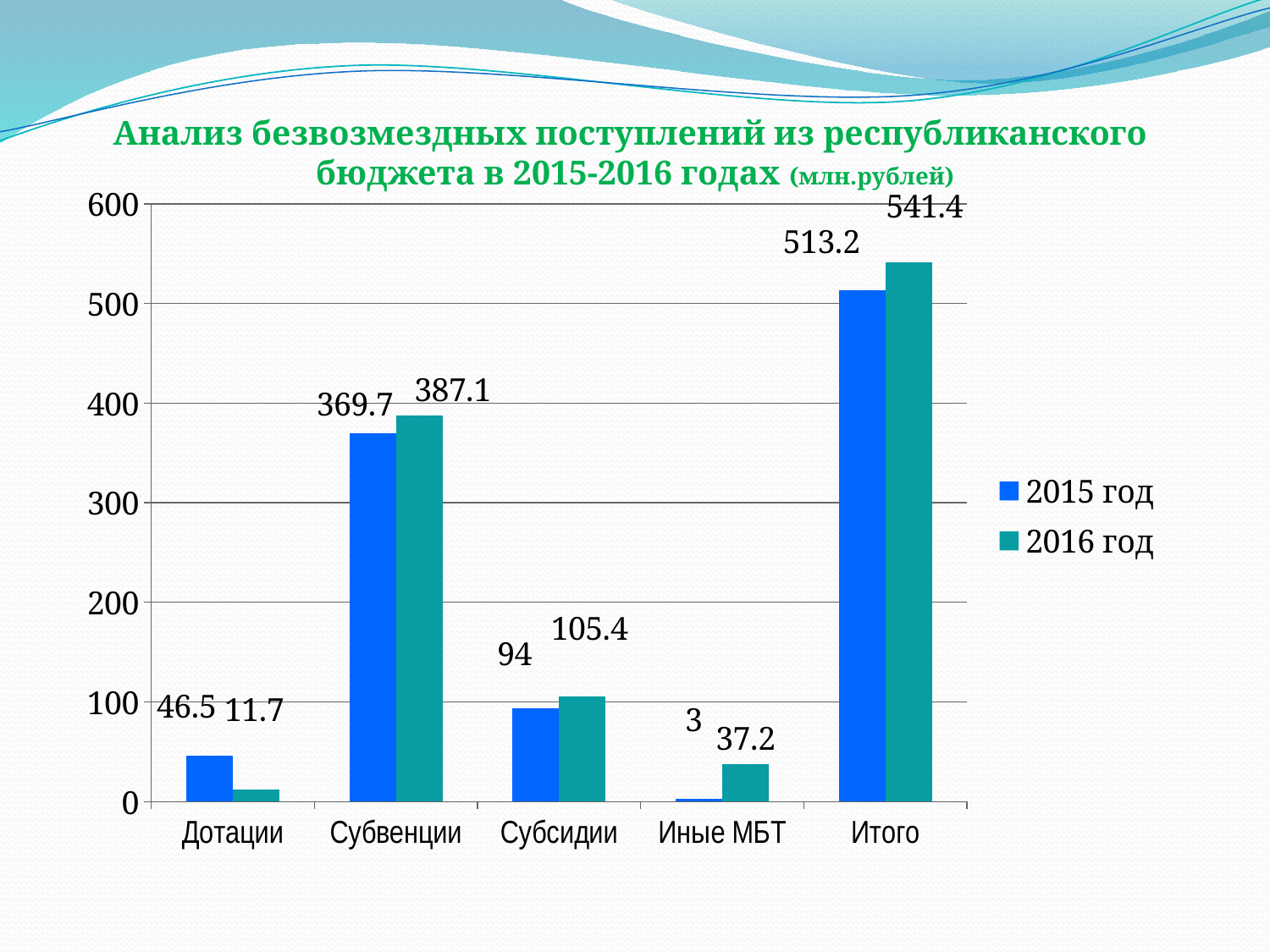
What is the value for Дотации in 2016 год? 11.7 Is the value for Субвенции in 2016 год greater or less than 400? less How many series does the legend list? 2 How many categories are shown on the x axis? 5 What is the value for Иные МБТ in 2016 год? 37.2 Which is larger for Дотации: the 2015 год value or the 2016 год value? 2015 год What is the difference between the 2016 год and 2015 год values for Субсидии? 11.4 Excluding Итого, which category has the highest value in 2016 год? Субвенции What is the value for Итого in 2015 год? 513.2 What kind of chart is shown on the slide? bar chart What is the value for Субвенции in 2015 год? 369.7 Which category has the lowest value in 2015 год? Иные МБТ